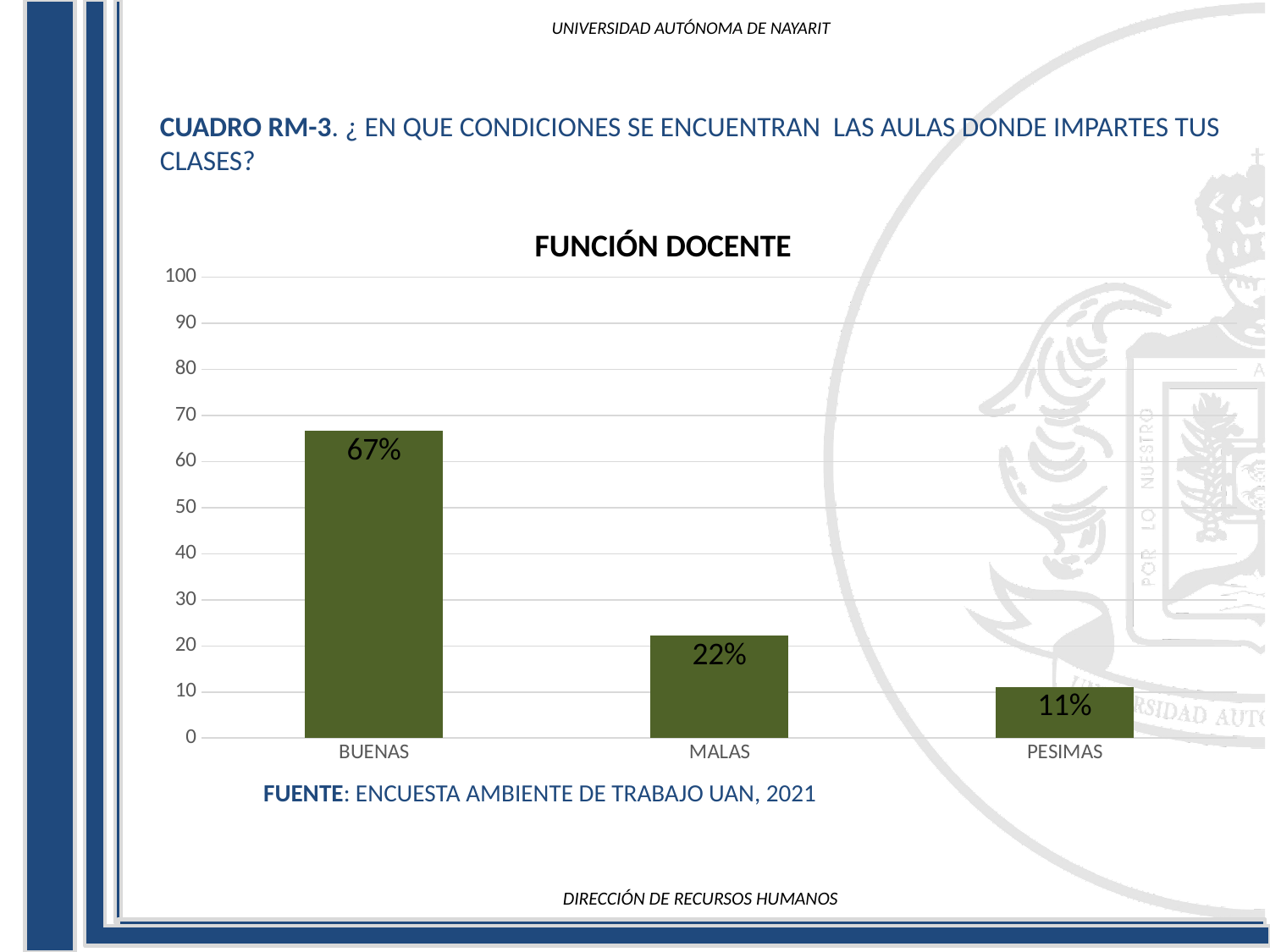
What is the value for PESIMAS? 11% Is the value for BUENAS greater or less than 50? greater How many categories are shown on the x axis? 3 What is the title of the chart? FUNCIÓN DOCENTE What is the difference between the values for MALAS and PESIMAS? 11% Which category has the highest value? BUENAS Which is larger, the value for MALAS or the value for PESIMAS? MALAS What is the value for MALAS? 22% What is the value for BUENAS? 67% What is the difference between the values for BUENAS and MALAS? 45% What kind of chart is shown on the slide? bar chart Which category has the lowest value? PESIMAS